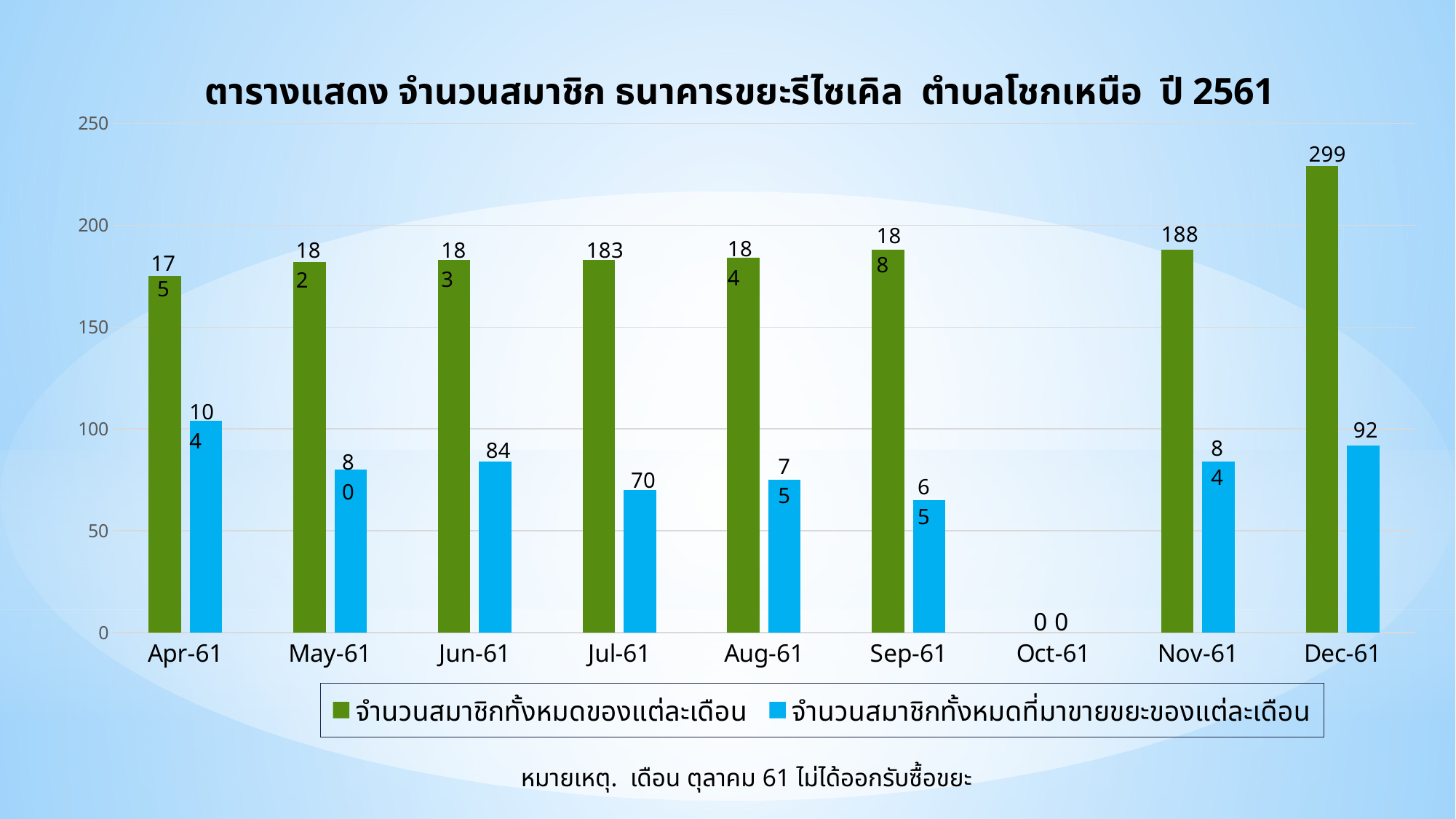
Is the green bar for Dec-61 greater or less than 200? greater What is the difference between the green series values for Nov-61 and Jul-61? 5 What is the value of the blue series (จำนวนสมาชิกทั้งหมดที่มาขายขยะของแต่ละเดือน) for Dec-61? 92 What kind of chart is shown on the slide? Bar chart Which month has the highest value for the green series (จำนวนสมาชิกทั้งหมดของแต่ละเดือน)? Dec-61 What is the value of the blue series (จำนวนสมาชิกทั้งหมดที่มาขายขยะของแต่ละเดือน) for Jun-61? 84 Which is larger for the blue series: Jun-61 or Jul-61? Jun-61 What is the value of the green series (จำนวนสมาชิกทั้งหมดของแต่ละเดือน) for Nov-61? 188 What is the value of the green series (จำนวนสมาชิกทั้งหมดของแต่ละเดือน) for Jul-61? 183 What value is shown for both series in Oct-61? 0 How many series does the legend list? 2 How many months are shown on the x axis? 9